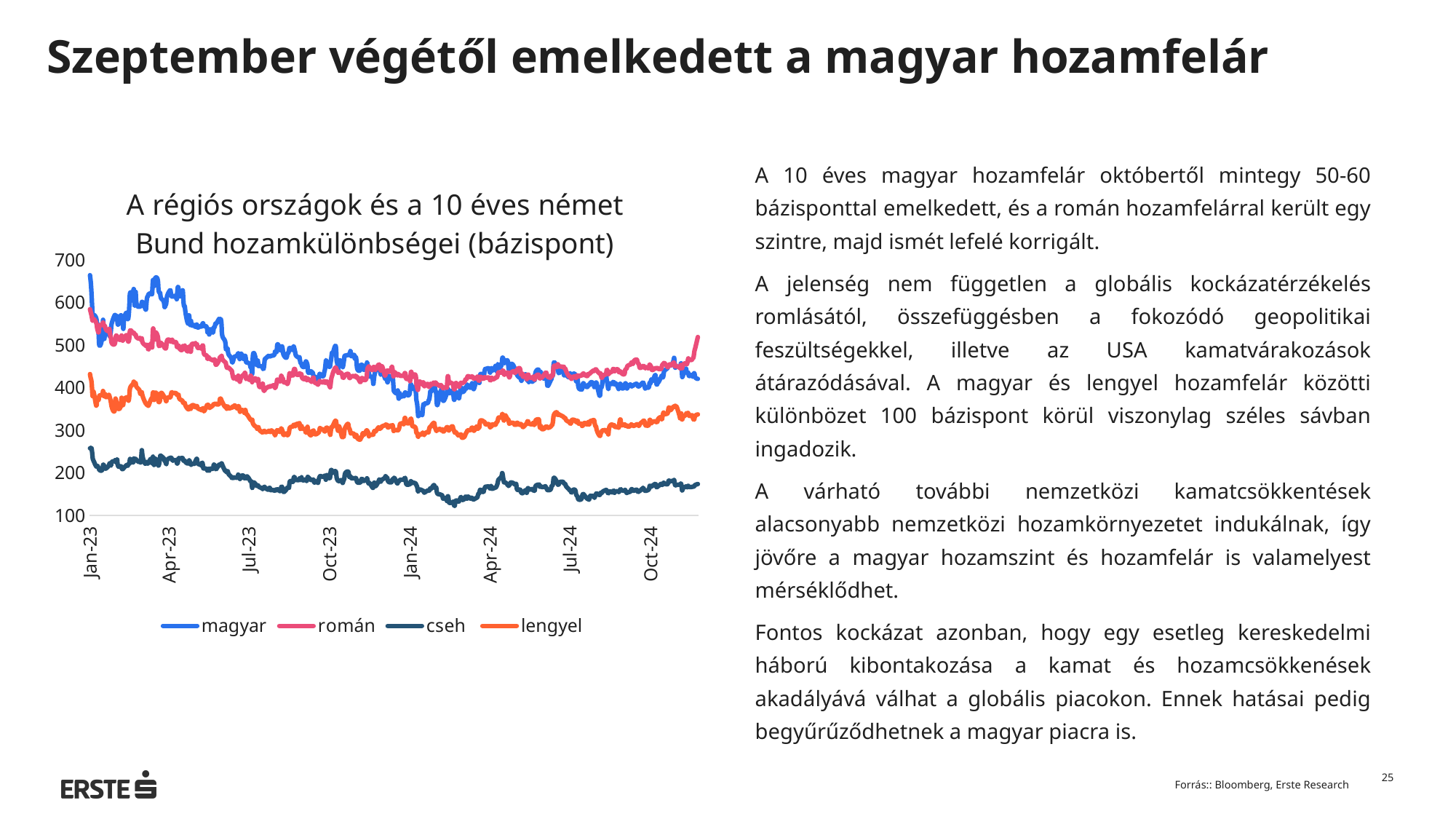
Is the value for lengyel at Jan-23 greater or less than 400? greater What kind of chart is shown on the slide? line chart Which series has the highest value at Jan-23? magyar Which series has the lowest values throughout the chart? cseh Is the value for magyar at Jan-23 greater or less than 600? greater At the right end of the chart, which series is higher: magyar or román? román How many series does the chart legend list? 4 How many date labels are shown on the x axis of the chart? 8 Which series are listed in the chart legend? magyar, román, cseh, lengyel What is the title of the chart? A régiós országok és a 10 éves német Bund hozamkülönbségei (bázispont) Does the magyar series rise or fall between Jan-23 and Jan-24? fall Is the value for cseh at Jan-24 greater or less than 200? less